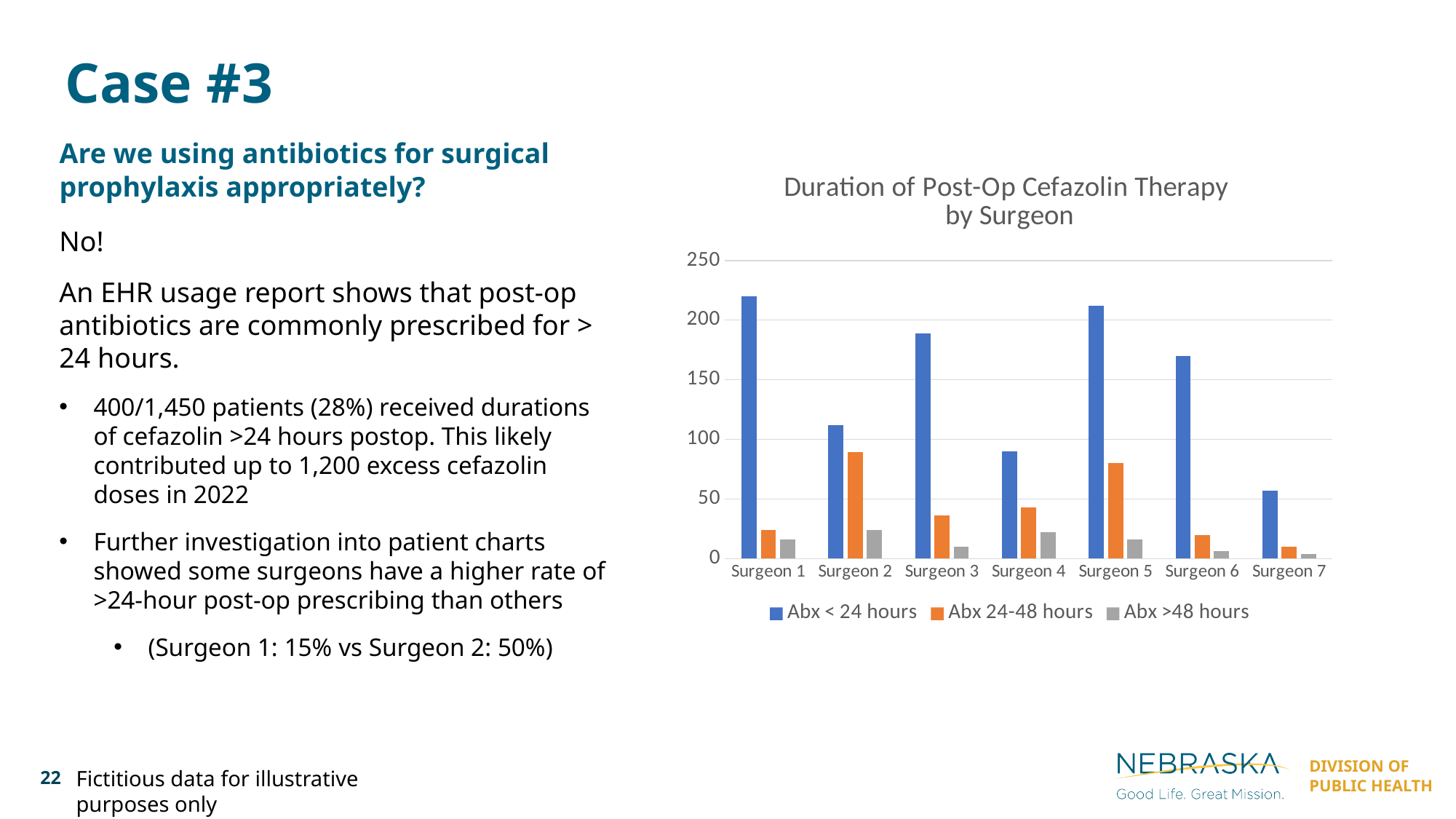
How many series does the chart legend list? 3 Which is larger: the Abx 24-48 hours value for Surgeon 2 or for Surgeon 4? Surgeon 2 Is the Abx < 24 hours value for Surgeon 6 greater or less than 150? greater Which surgeon has the lowest value for Abx < 24 hours? Surgeon 7 Is the Abx < 24 hours value for Surgeon 1 greater or less than 200? greater How many surgeons are shown on the x axis of the chart? 7 Which is larger: the Abx < 24 hours value for Surgeon 3 or for Surgeon 6? Surgeon 3 What is the title of the chart? Duration of Post-Op Cefazolin Therapy by Surgeon What kind of chart is shown on the slide? Bar chart Is the Abx 24-48 hours value for Surgeon 5 greater or less than 50? greater Which surgeon has the highest value for Abx 24-48 hours? Surgeon 2